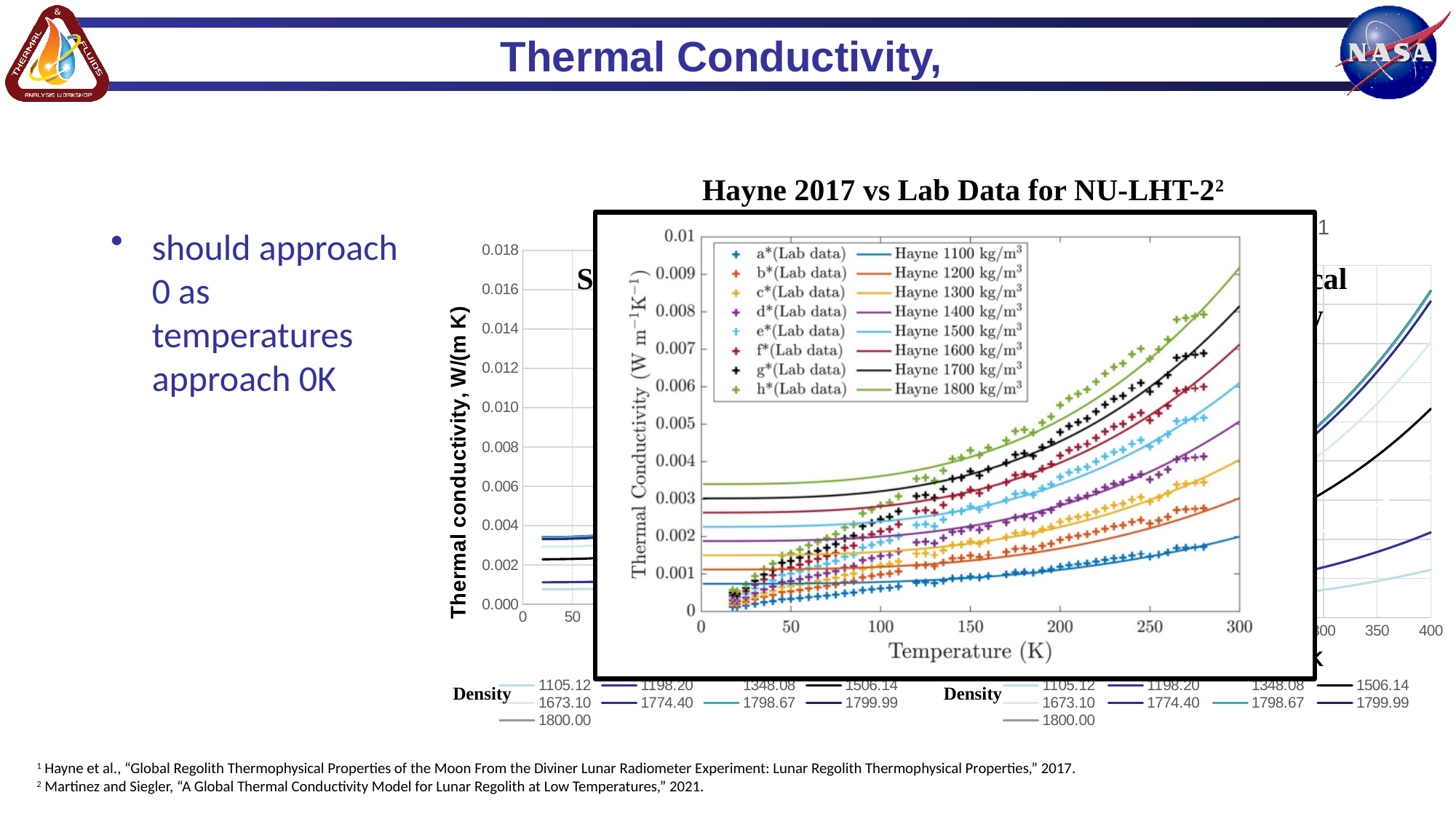
In the 'Hayne 2017 vs Lab Data for NU-LHT-2' chart, do the thermal conductivity values rise or fall as temperature increases? rise In the 'Hayne 2017 vs Lab Data for NU-LHT-2' chart, which Hayne curve has the highest thermal conductivity at 300 K? Hayne 1800 kg/m³ In the 'Hayne 2017 vs Lab Data for NU-LHT-2' chart, is the Hayne 1800 kg/m³ value at 300 K greater or less than 0.008? greater In the 'Hayne 2017 vs Lab Data for NU-LHT-2' chart, which is larger at 300 K: the Hayne 1600 kg/m³ curve or the Hayne 1200 kg/m³ curve? Hayne 1600 kg/m³ In the 'Hayne 2017 vs Lab Data for NU-LHT-2' chart, how many entries does the legend list? 16 What is the title of the chart overlaid in the centre of the slide? Hayne 2017 vs Lab Data for NU-LHT-2 In the 'Hayne 2017 vs Lab Data for NU-LHT-2' chart, which Hayne curve has the lowest thermal conductivity at 300 K? Hayne 1100 kg/m³ In the 'Hayne 2017 vs Lab Data for NU-LHT-2' chart, how many Hayne model curves are listed in the legend? 8 In the 'Hayne 2017 vs Lab Data for NU-LHT-2' chart, what is the label of the x axis? Temperature (K) In the 'Hayne 2017 vs Lab Data for NU-LHT-2' chart, is the Hayne 1800 kg/m³ value at 0 K greater or less than 0.003? greater In the 'Hayne 2017 vs Lab Data for NU-LHT-2' chart, what kind of chart is shown? line chart